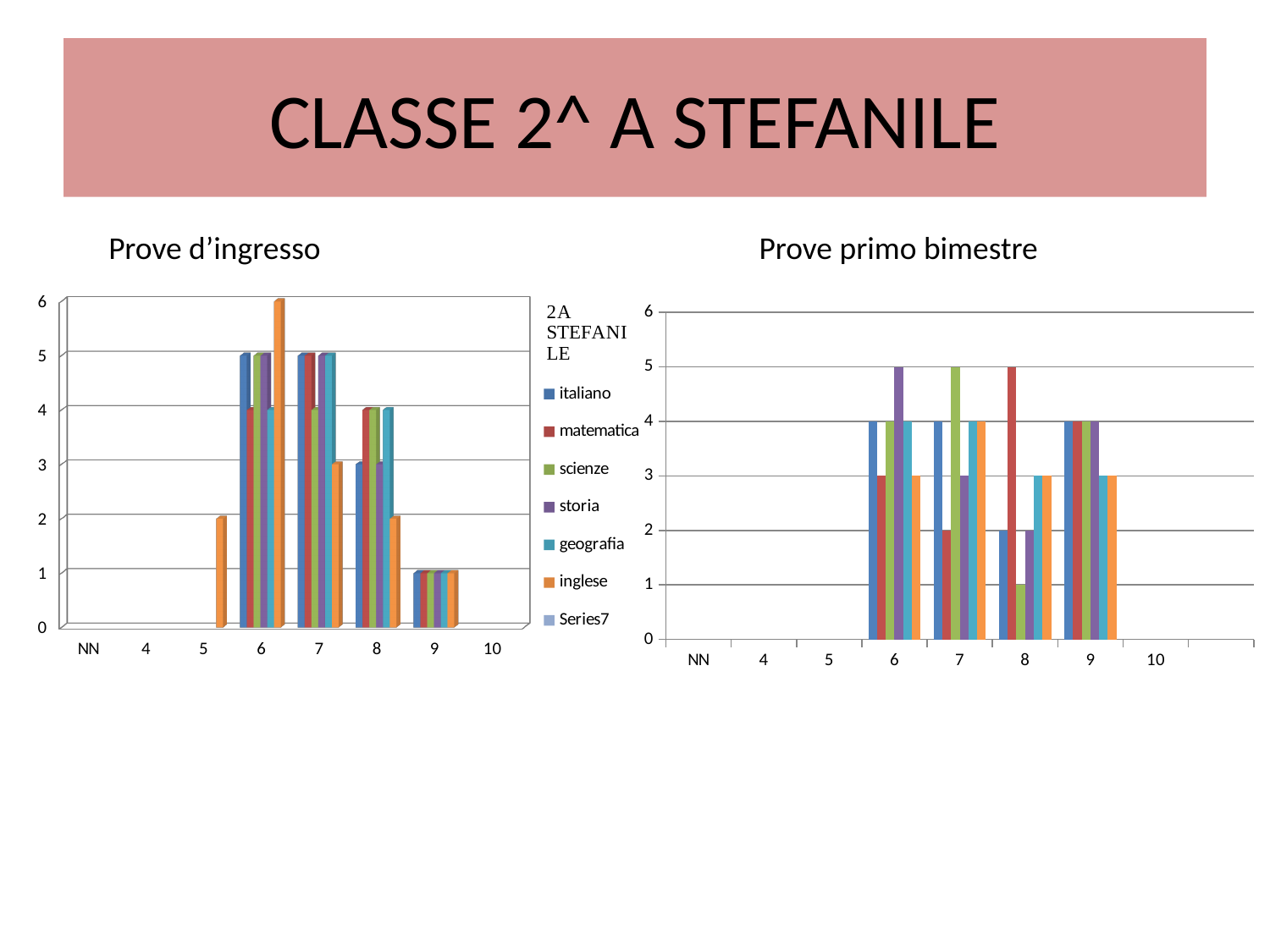
How many series does the legend on the slide list? 7 In the 'Prove d'ingresso' chart, is the value for inglese at category 7 greater or less than 4? less In the 'Prove d'ingresso' chart, what is the value for inglese at category 5? 2 In the 'Prove d'ingresso' chart, what is the value for inglese at category 6? 6 In the 'Prove primo bimestre' chart, what is the value for scienze at category 8? 1 In the 'Prove primo bimestre' chart, which is larger at category 7: scienze or matematica? scienze What kind of chart is 'Prove primo bimestre'? bar chart In the 'Prove primo bimestre' chart, what is the value for matematica at category 8? 5 In the 'Prove d'ingresso' chart, which category has the highest bar overall? 6 In the 'Prove d'ingresso' chart, what is the value for italiano at category 8? 3 How many categories are shown on the x axis of the 'Prove primo bimestre' chart? 8 In the 'Prove primo bimestre' chart, what is the difference between storia at category 6 and storia at category 8? 3